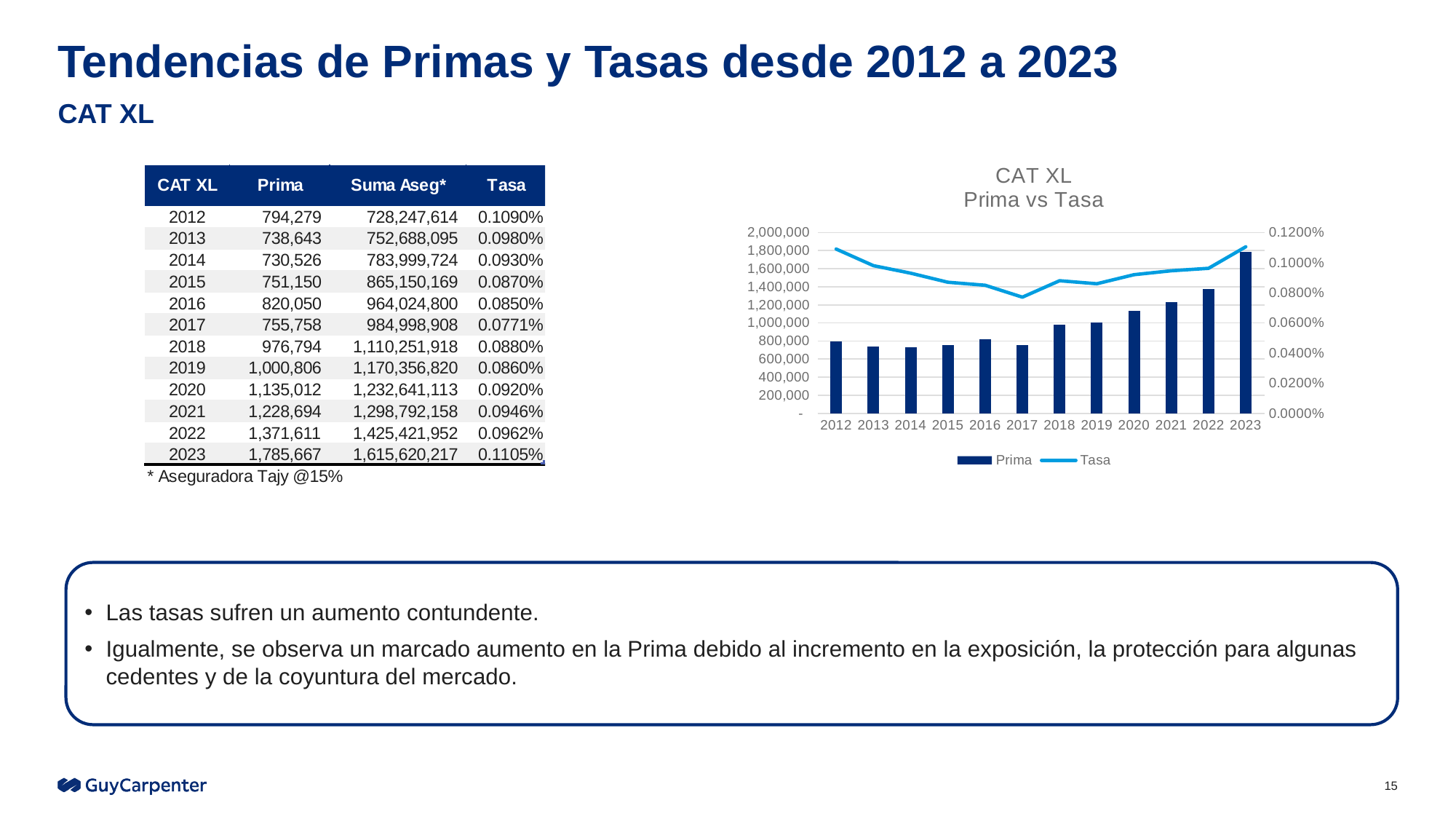
Is the Prima value for 2012 greater or less than 1,000,000? less Does the Prima rise or fall from 2017 to 2023? rise What is the Tasa value for 2012? 0.1090% How many years are plotted on the x axis of the CAT XL Prima vs Tasa chart? 12 Which year has the highest Prima in the CAT XL Prima vs Tasa chart? 2023 What kind of chart is shown on the slide? bar chart with a line Which year has the lowest Tasa in the CAT XL Prima vs Tasa chart? 2017 Which year has the larger Prima, 2017 or 2018? 2018 What is the Prima value for 2023? 1,785,667 What is the difference between the Prima for 2023 and the Prima for 2012? 991,388 Is the Prima value for 2023 greater or less than 1,600,000? greater How many series does the legend of the CAT XL Prima vs Tasa chart list? 2